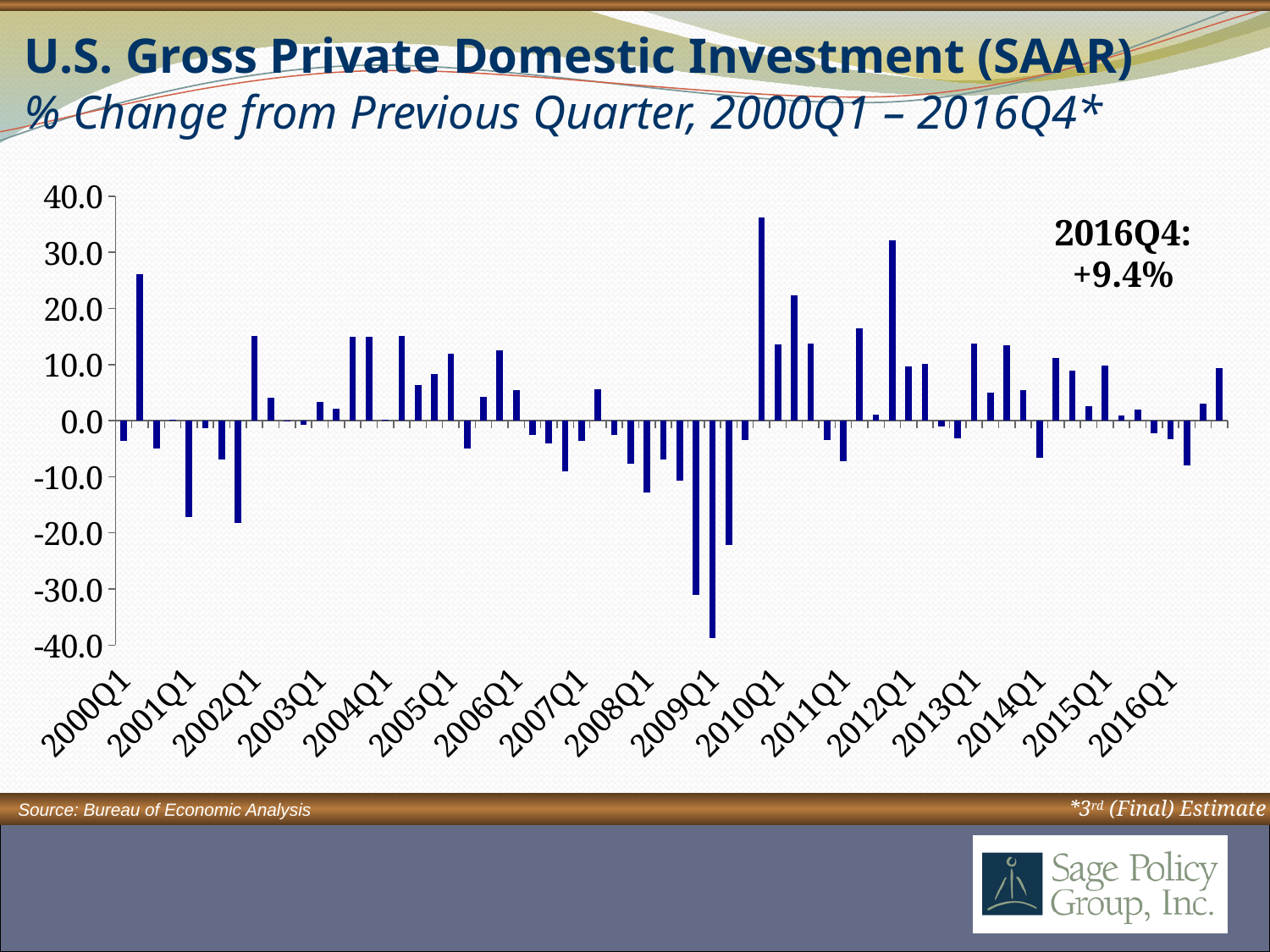
How many quarter labels are shown on the x axis? 17 Is the value for 2016Q4 greater or less than 10.0? less What is the title of the chart? U.S. Gross Private Domestic Investment (SAAR) What is the value for 2016Q4? +9.4% Is the value for 2016Q4 greater or less than 0.0? greater Is the lowest value on the chart greater or less than -30.0? less What kind of chart is shown on the slide? bar chart What is the source of the data shown in the chart? Bureau of Economic Analysis